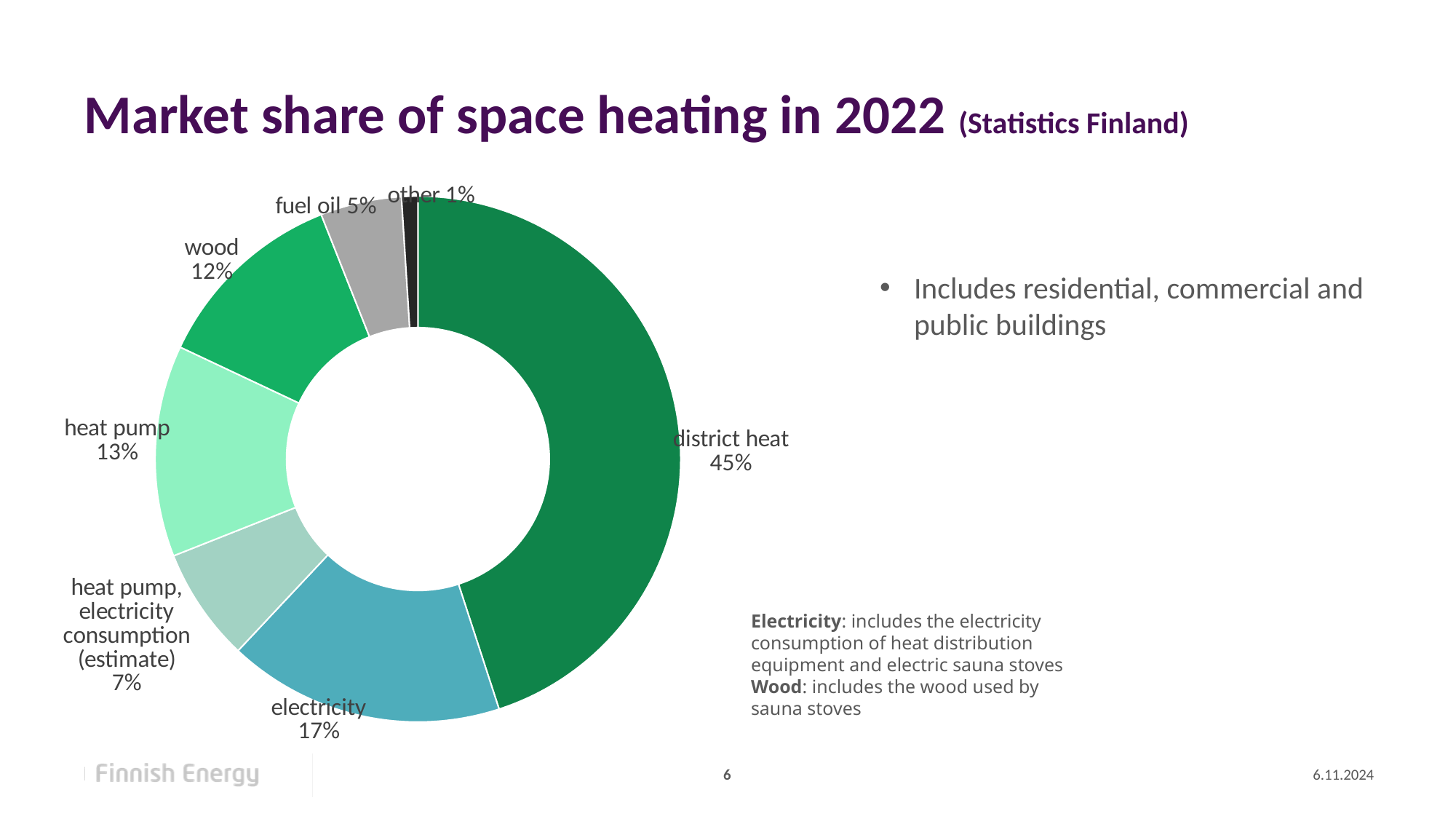
What is the market share of heat pump, electricity consumption (estimate)? 7% What is the difference between the market share of district heat and electricity? 28% How many categories are shown in the chart? 7 What is the market share of heat pump? 13% What is the market share of district heat? 45% What is the market share of wood? 12% What is the market share of fuel oil? 5% Which has a larger market share, heat pump or wood? heat pump What is the market share of electricity? 17% Which category has the largest market share? district heat What kind of chart is shown on the slide? doughnut chart Which category has the smallest market share? other